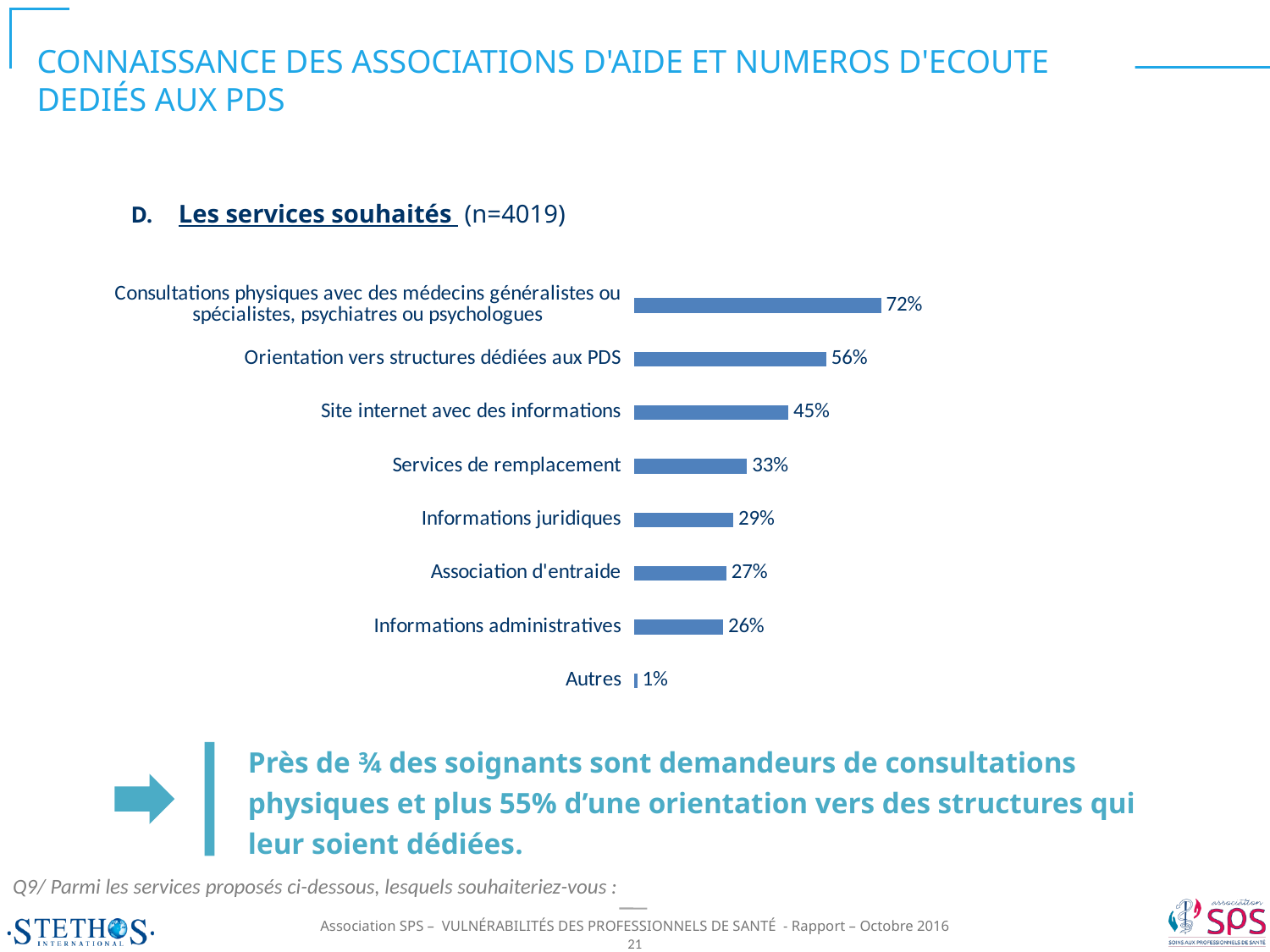
What is the value for "Orientation vers structures dédiées aux PDS"? 56% What kind of chart is shown on the slide? Bar chart What is the difference between the values for "Services de remplacement" and "Informations administratives"? 7% What is the value for "Site internet avec des informations"? 45% What is the value for "Informations juridiques"? 29% Which is larger, the value for "Association d'entraide" or the value for "Informations administratives"? Association d'entraide What is the difference between the values for "Consultations physiques avec des médecins généralistes ou spécialistes, psychiatres ou psychologues" and "Orientation vers structures dédiées aux PDS"? 16% What is the value for "Autres"? 1% Which category has the lowest value? Autres Which category has the highest value? Consultations physiques avec des médecins généralistes ou spécialistes, psychiatres ou psychologues How many categories are shown in the chart? 8 What is the sample size (n) stated in the chart heading? n=4019